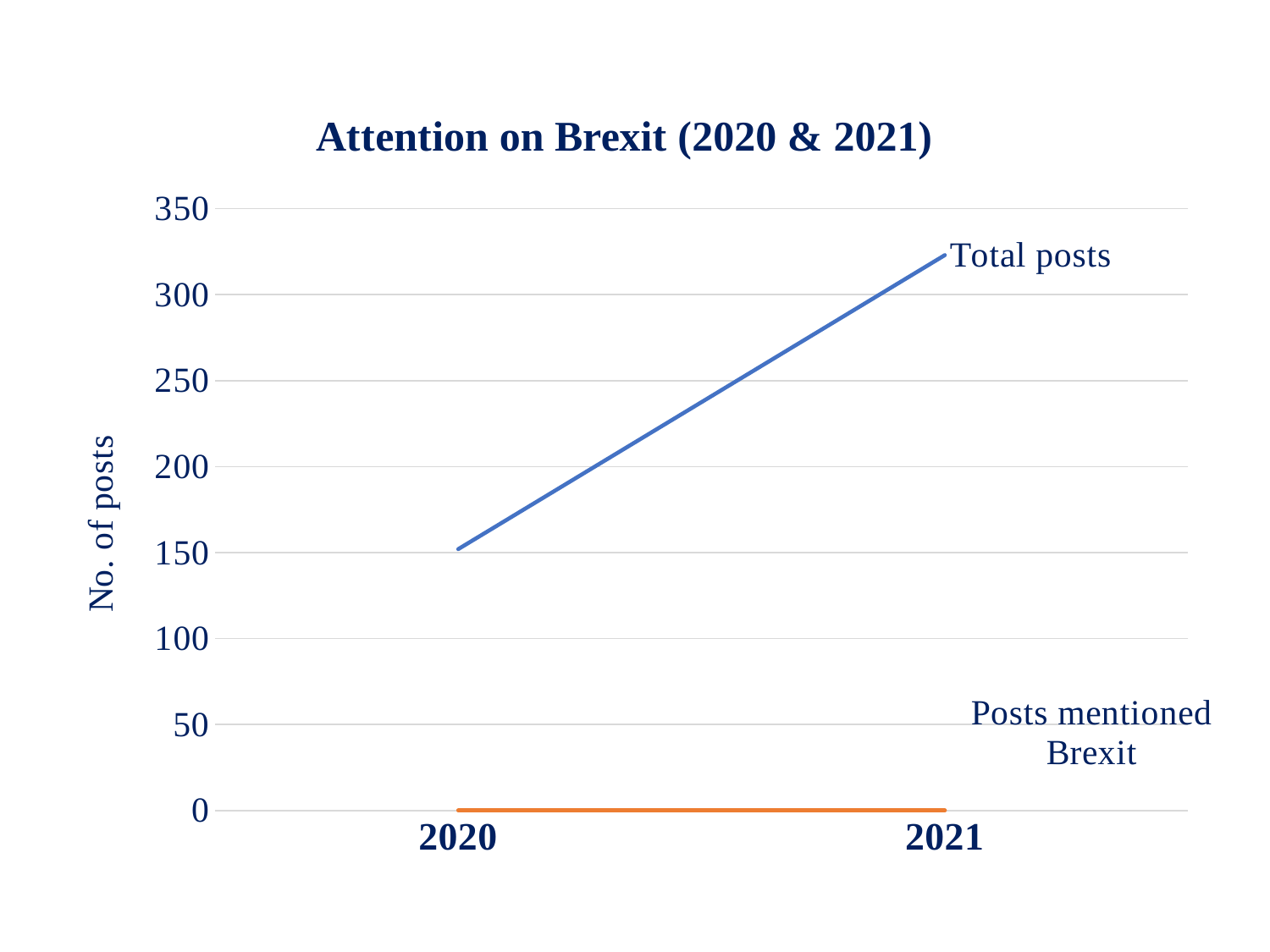
Is the value for Total posts in 2021 greater or less than 300? greater What is the label of the y axis? No. of posts How many series are plotted on the chart? 2 Is the value for Total posts in 2021 greater or less than 350? less Is the value for Total posts in 2020 greater or less than 200? less What is the value for Posts mentioned Brexit in 2020? 0 How many years are shown on the x axis? 2 Which series has the higher value in 2021, Total posts or Posts mentioned Brexit? Total posts Does the Total posts line rise or fall from 2020 to 2021? rise What kind of chart is shown on the slide? line chart What is the title of the chart? Attention on Brexit (2020 & 2021)